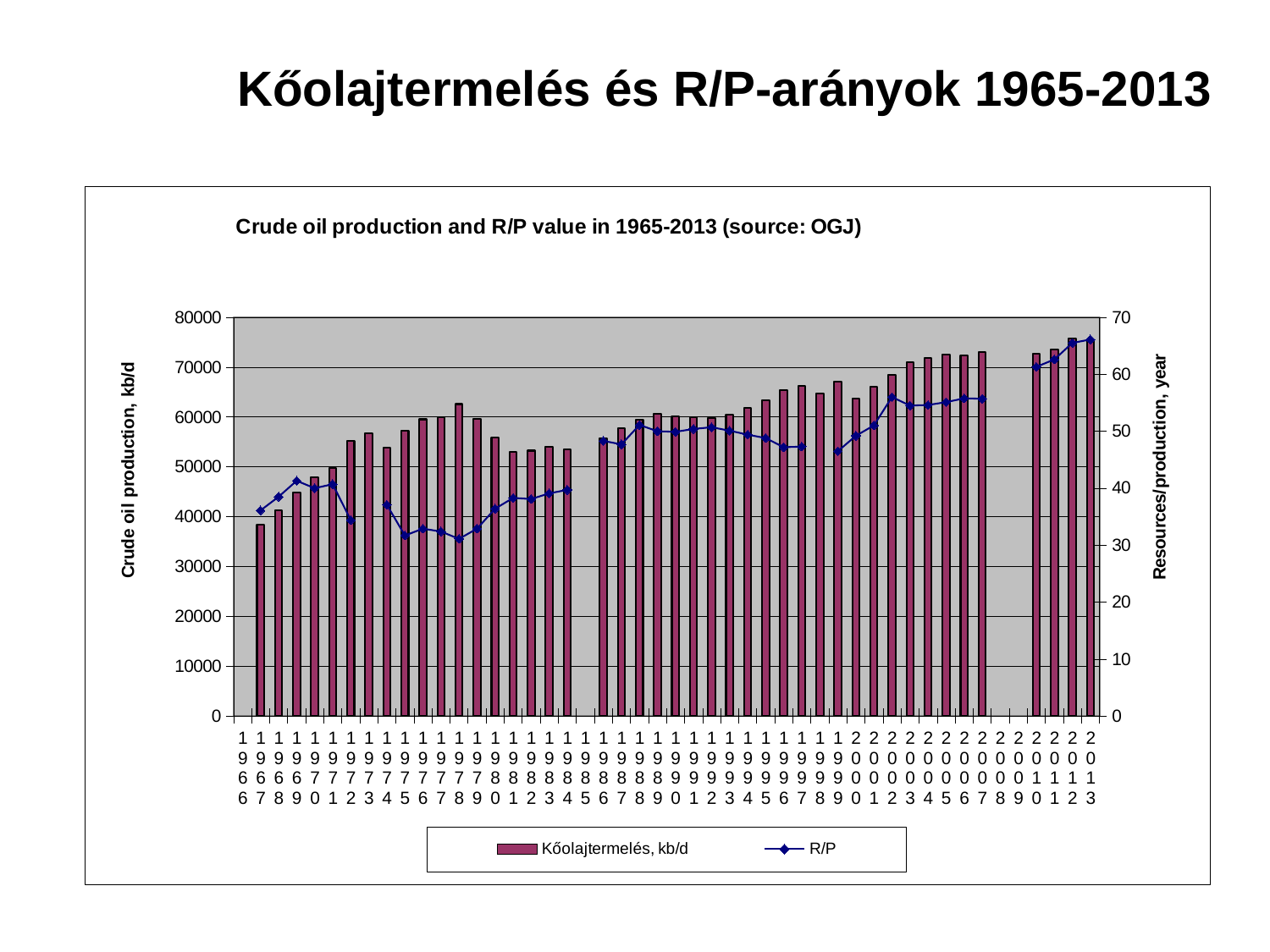
What is the label of the right-hand vertical axis? Resources/production, year Is the crude oil production bar for 1978 greater or less than 60000? greater Is the R/P value for 2013 greater or less than 60? greater Overall, do the crude oil production bars rise or fall from 1966 to 2013? rise Is the R/P value for 1978 greater or less than 40? less Which year has the lowest crude oil production bar? 1967 How many series does the legend list? 2 What is the title of the chart? Crude oil production and R/P value in 1965-2013 (source: OGJ) Which is larger, the crude oil production bar for 2013 or for 1967? 2013 What kind of chart is shown on the slide? A combined bar and line chart